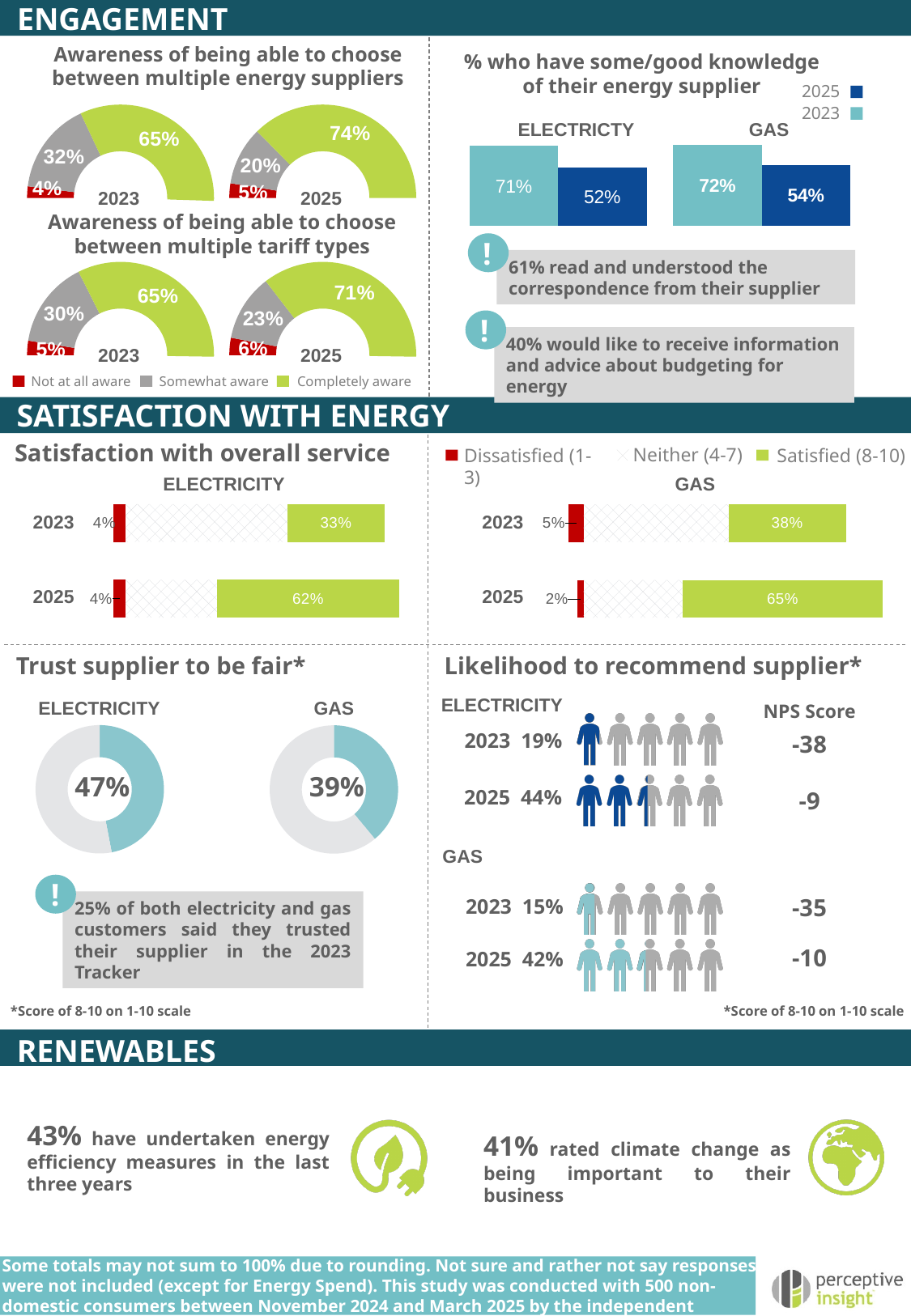
In the 'Awareness of being able to choose between multiple tariff types' chart, what percentage were not at all aware in 2025? 6% In the 'Satisfaction with overall service' chart, what percentage of gas customers were satisfied in 2025? 65% In the '% who have some/good knowledge of their energy supplier' chart, how many series does the legend list? 2 What type of chart is used for 'Trust supplier to be fair'? Donut chart In the 'Trust supplier to be fair' chart, which has the higher value, electricity or gas? Electricity In the 'Awareness of being able to choose between multiple energy suppliers' chart, what percentage were somewhat aware in 2023? 32% In the 'Awareness of being able to choose between multiple tariff types' chart, by how many percentage points did the completely aware share change from 2023 to 2025? 6 percentage points In the 'Likelihood to recommend supplier' chart, what is the NPS Score for gas in 2023? -35 In the '% who have some/good knowledge of their energy supplier' chart, which year has the higher value for electricity, 2023 or 2025? 2023 In the '% who have some/good knowledge of their energy supplier' chart, what is the 2025 value for gas? 54% In the 'Satisfaction with overall service' chart, what is the difference between the electricity satisfied share in 2025 and in 2023? 29 percentage points In the 'Awareness of being able to choose between multiple energy suppliers' chart, what percentage were completely aware in 2025? 74%